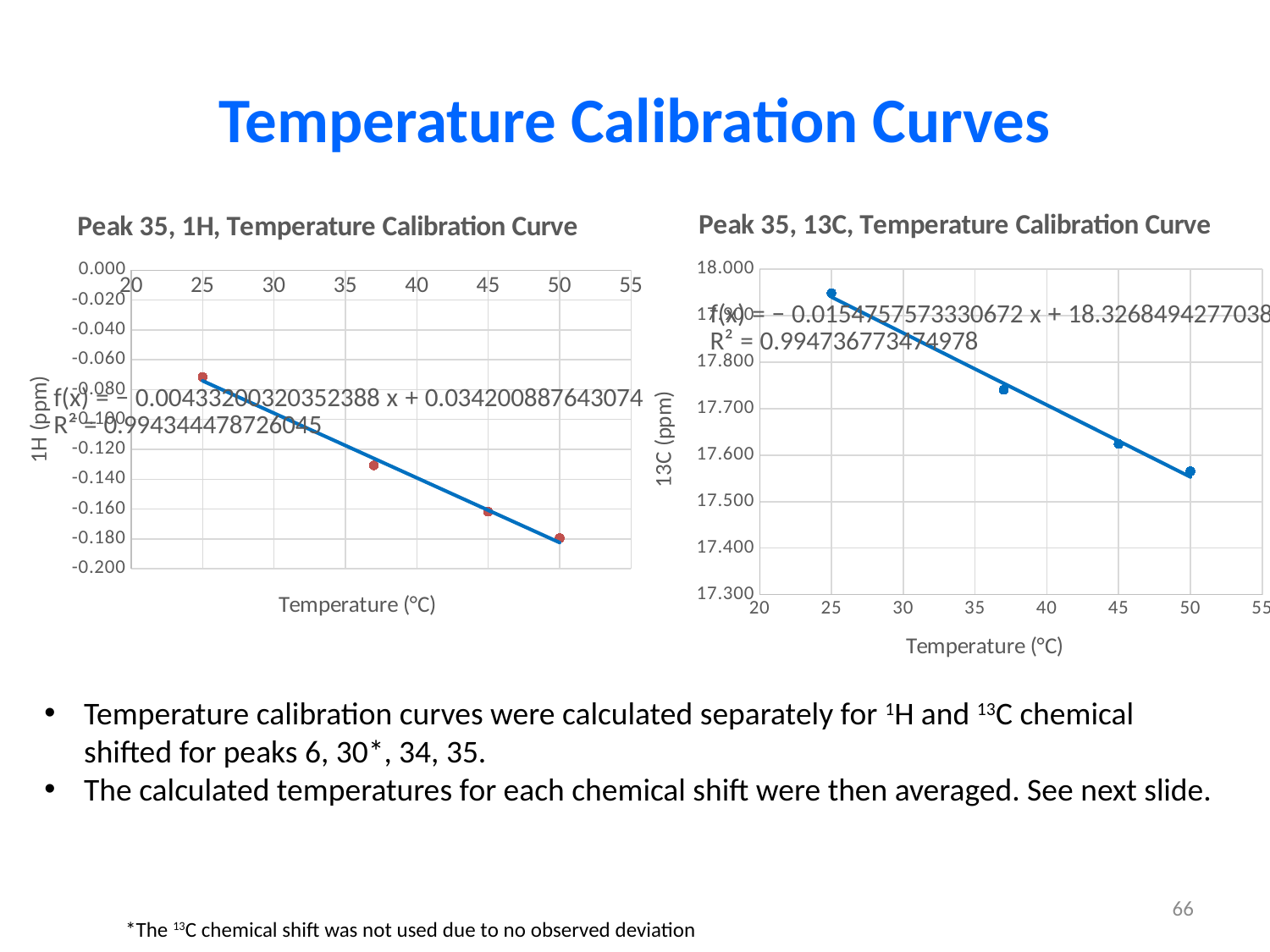
How many data points are plotted on the 'Peak 35, 13C, Temperature Calibration Curve' chart? 4 On the 'Peak 35, 13C, Temperature Calibration Curve' chart, is the value at 25 °C greater or less than 17.900? greater What is the label of the x axis on the 'Peak 35, 1H, Temperature Calibration Curve' chart? Temperature (°C) What is the R² value shown on the 'Peak 35, 13C, Temperature Calibration Curve' chart? 0.994736773474978 On the 'Peak 35, 1H, Temperature Calibration Curve' chart, do the values rise or fall as temperature increases? fall On the 'Peak 35, 1H, Temperature Calibration Curve' chart, at which temperature is the 1H chemical shift lowest? 50 °C On the 'Peak 35, 13C, Temperature Calibration Curve' chart, do the values rise or fall as temperature increases? fall How many data points are plotted on the 'Peak 35, 1H, Temperature Calibration Curve' chart? 4 On the 'Peak 35, 13C, Temperature Calibration Curve' chart, at which temperature is the 13C chemical shift highest? 25 °C On the 'Peak 35, 13C, Temperature Calibration Curve' chart, is the value at 50 °C greater or less than 17.600? less On the 'Peak 35, 13C, Temperature Calibration Curve' chart, is the value at 37 °C greater or less than 17.800? less What kind of chart is the 'Peak 35, 1H, Temperature Calibration Curve'? scatter chart